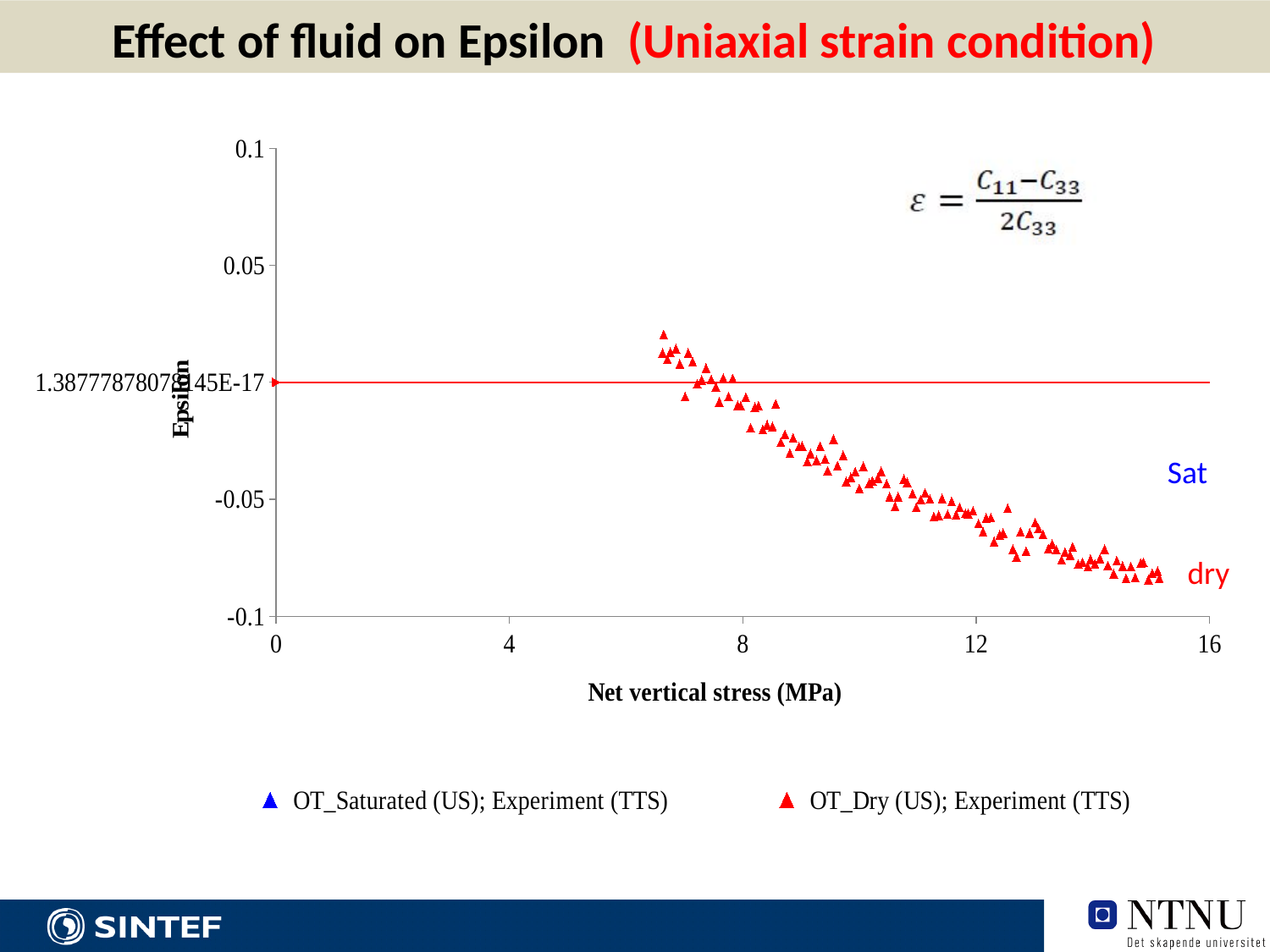
Do the OT_Dry (US); Experiment (TTS) values rise or fall as net vertical stress increases? fall How many series does the legend list? 2 What are the two series named in the legend? OT_Saturated (US); Experiment (TTS) and OT_Dry (US); Experiment (TTS) What is the title of the x axis? Net vertical stress (MPa) Is the OT_Dry (US); Experiment (TTS) value at a net vertical stress of 9 MPa greater or less than -0.05? greater Is the OT_Dry (US); Experiment (TTS) value at a net vertical stress of 14 MPa greater or less than -0.05? less Is the OT_Dry (US); Experiment (TTS) value at a net vertical stress of 14 MPa greater or less than -0.1? greater What kind of chart is shown on the slide? scatter chart